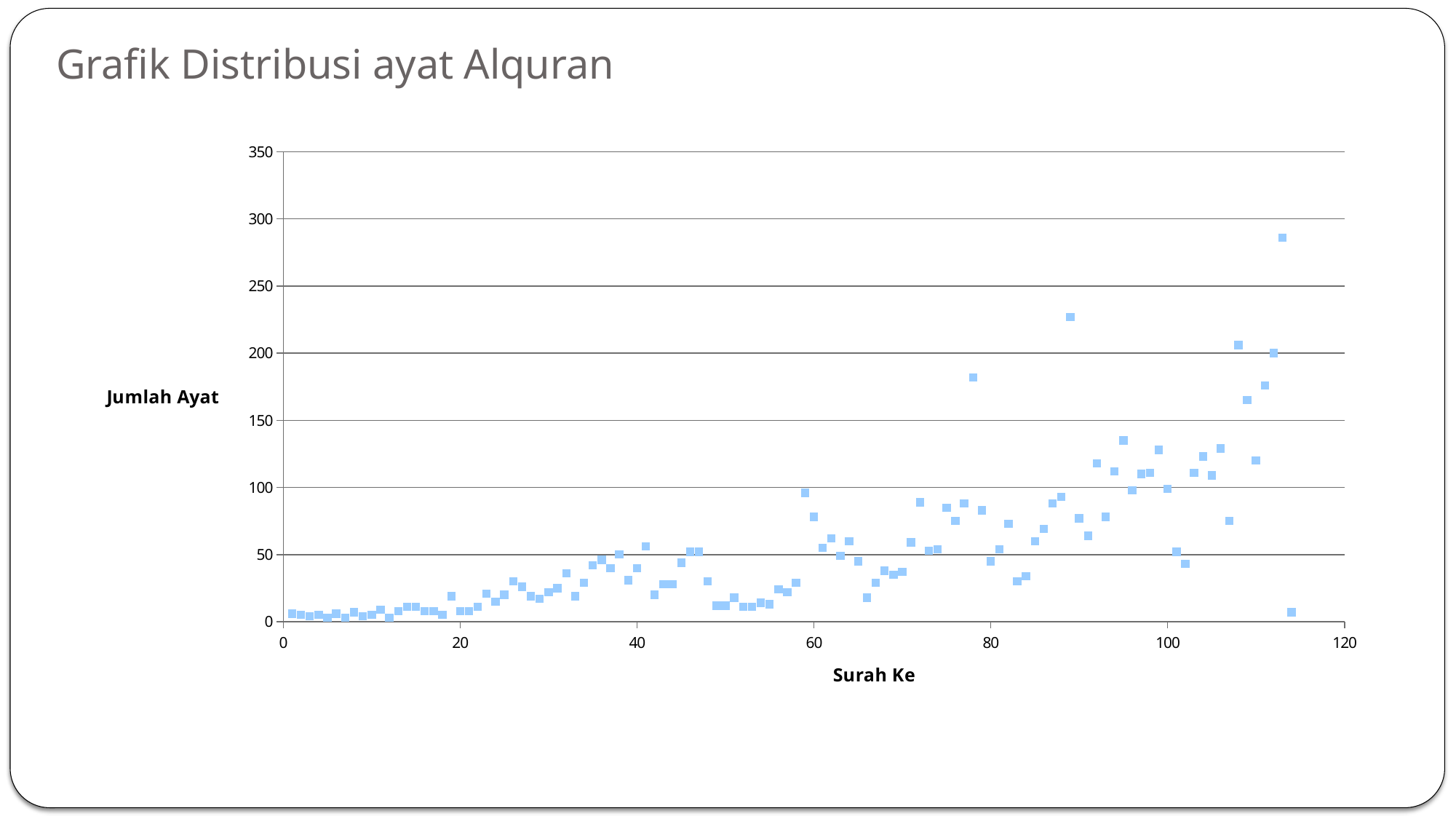
Do the plotted values generally rise or fall as the Surah number increases along the x axis? rise What kind of chart is shown on the slide? scatter chart What is the label of the horizontal (x) axis? Surah Ke Is the highest plotted value on the chart greater or less than 300? less Is the highest plotted value on the chart greater or less than 250? greater What is the title of the chart? Grafik Distribusi ayat Alquran Are the plotted values for the first 20 surahs greater or less than 50? less What is the maximum value shown on the vertical (y) axis? 350